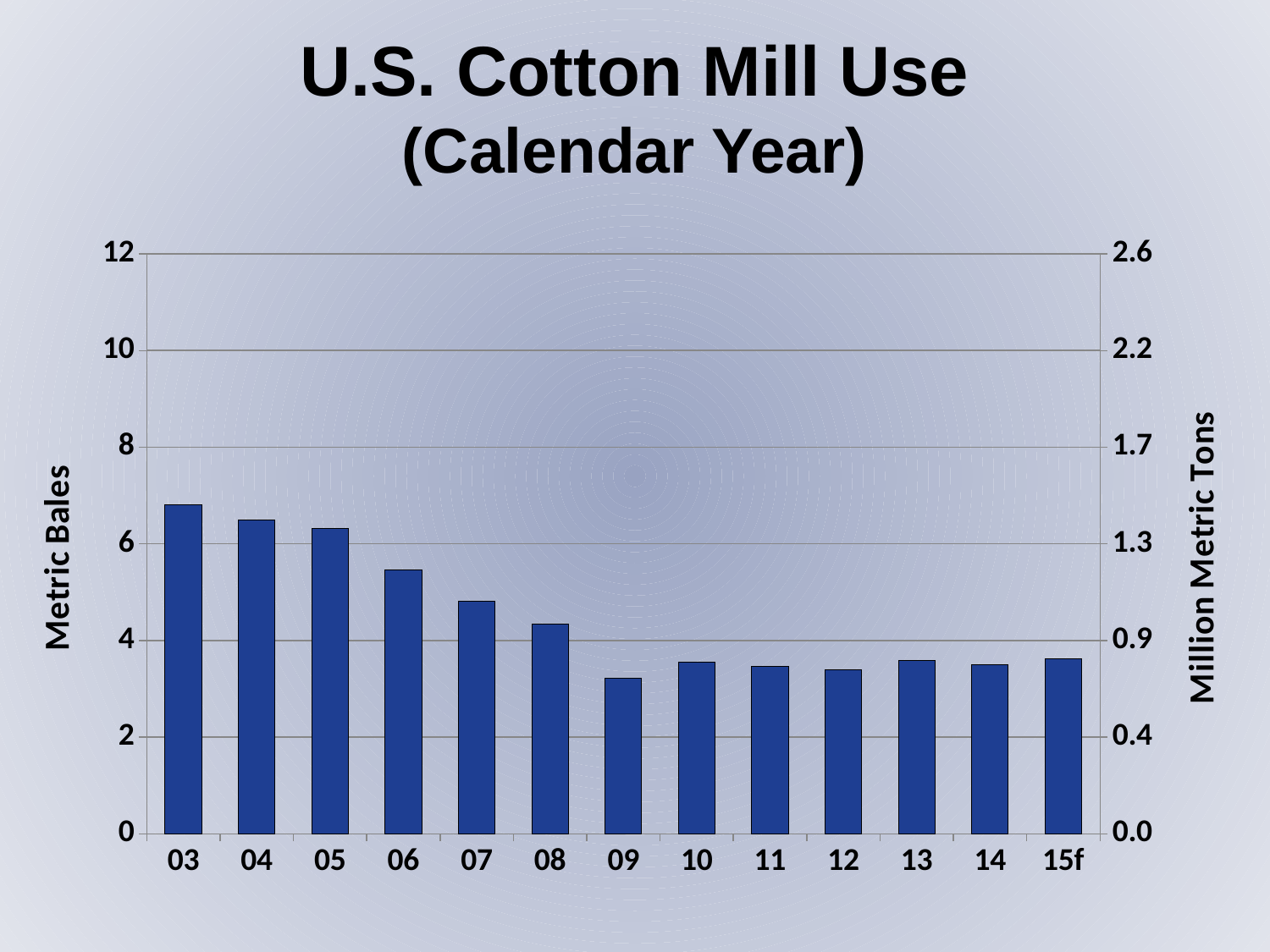
What kind of chart is shown on the slide? bar chart Which is larger, the value for 04 or the value for 10? 04 How many years (bars) are plotted in the chart? 13 Is the value for 03 greater or less than 6 on the left axis? greater Is the value for 06 greater or less than 6 on the left axis? less Is the value for 15f greater or less than 4 on the left axis? less Which is larger, the value for 06 or the value for 08? 06 What is the title of the left vertical axis? Metric Bales Do the values generally rise or fall from 03 to 09? fall Which year has the highest U.S. cotton mill use? 03